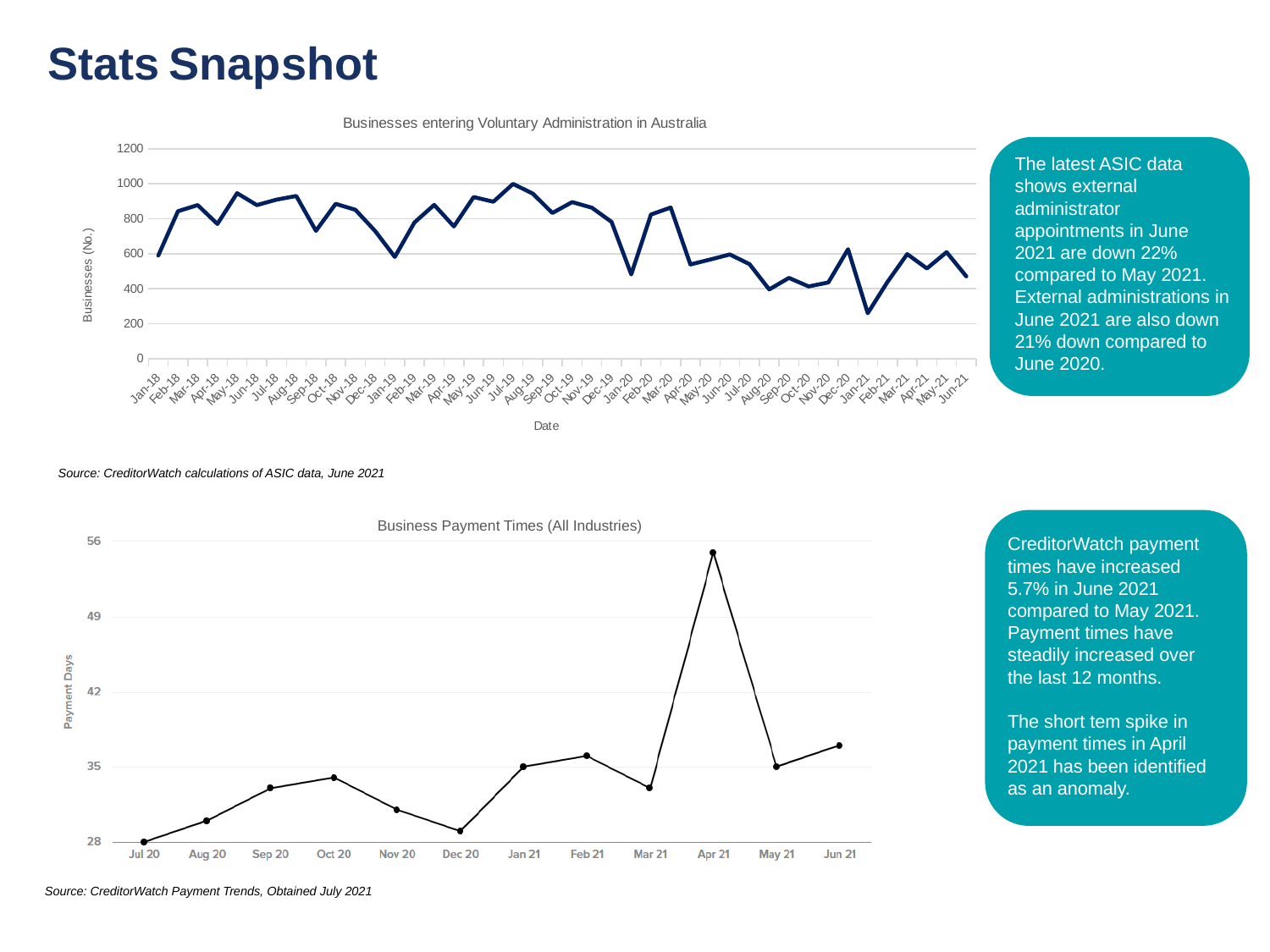
What kind of chart is the 'Businesses entering Voluntary Administration in Australia' chart? Line chart In the 'Businesses entering Voluntary Administration in Australia' chart, is the value for Jan-21 greater or less than 400? less In the 'Business Payment Times (All Industries)' chart, which month has the lowest payment days? Jul 20 In the 'Businesses entering Voluntary Administration in Australia' chart, which is larger, the value for Jan-18 or Jun-18? Jun-18 What kind of chart is the 'Business Payment Times (All Industries)' chart? Line chart In the 'Business Payment Times (All Industries)' chart, do payment days rise or fall from Jul 20 to Oct 20? Rise In the 'Business Payment Times (All Industries)' chart, how many months are plotted on the x axis? 12 In the 'Businesses entering Voluntary Administration in Australia' chart, is the value for Jul-19 greater or less than 800? greater In the 'Business Payment Times (All Industries)' chart, is the value for Apr 21 greater or less than 49? greater What is the y-axis label of the 'Business Payment Times (All Industries)' chart? Payment Days In the 'Business Payment Times (All Industries)' chart, which month has the highest payment days? Apr 21 In the 'Business Payment Times (All Industries)' chart, which is larger, the value for Apr 21 or May 21? Apr 21